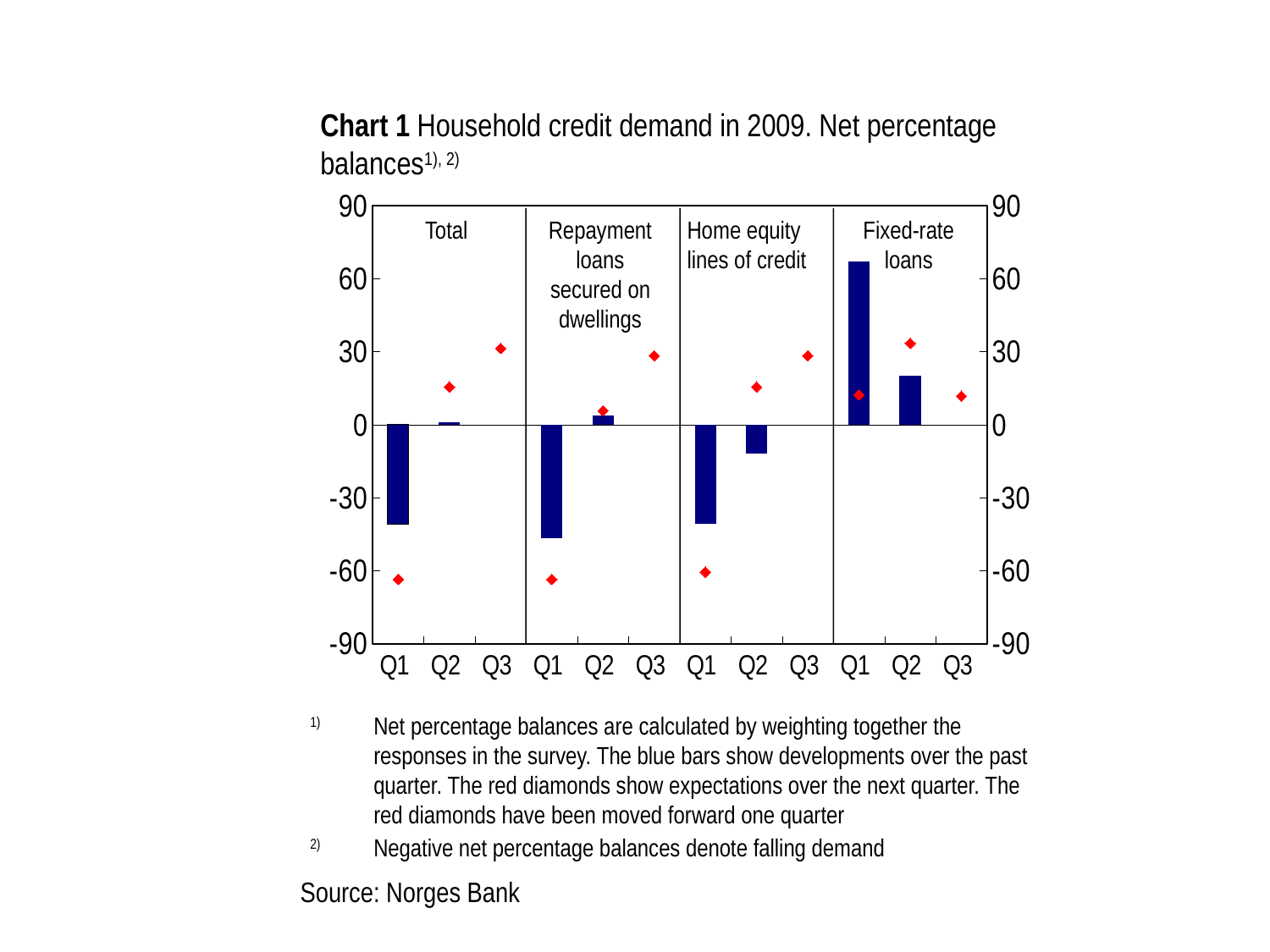
According to the footnote, what do the red diamonds in Chart 1 show? Expectations over the next quarter Is the Q2 blue bar for Home equity lines of credit greater or less than -30? greater How many quarters are shown on the x axis within each panel of Chart 1? 3 In which panel and quarter is the lowest blue bar in Chart 1? Repayment loans secured on dwellings, Q1 Is the Q1 blue bar for Fixed-rate loans greater or less than 60? greater Which has the lower Q1 blue bar: Repayment loans secured on dwellings or Home equity lines of credit? Repayment loans secured on dwellings How many loan categories (panels) does Chart 1 show? 4 In the Total panel, do the red diamonds rise or fall from Q1 to Q3? rise Is the Q1 blue bar for Total greater or less than -30? less What is the source given for Chart 1? Norges Bank In which panel and quarter is the tallest blue bar in Chart 1? Fixed-rate loans, Q1 What kind of chart is Chart 1? bar chart